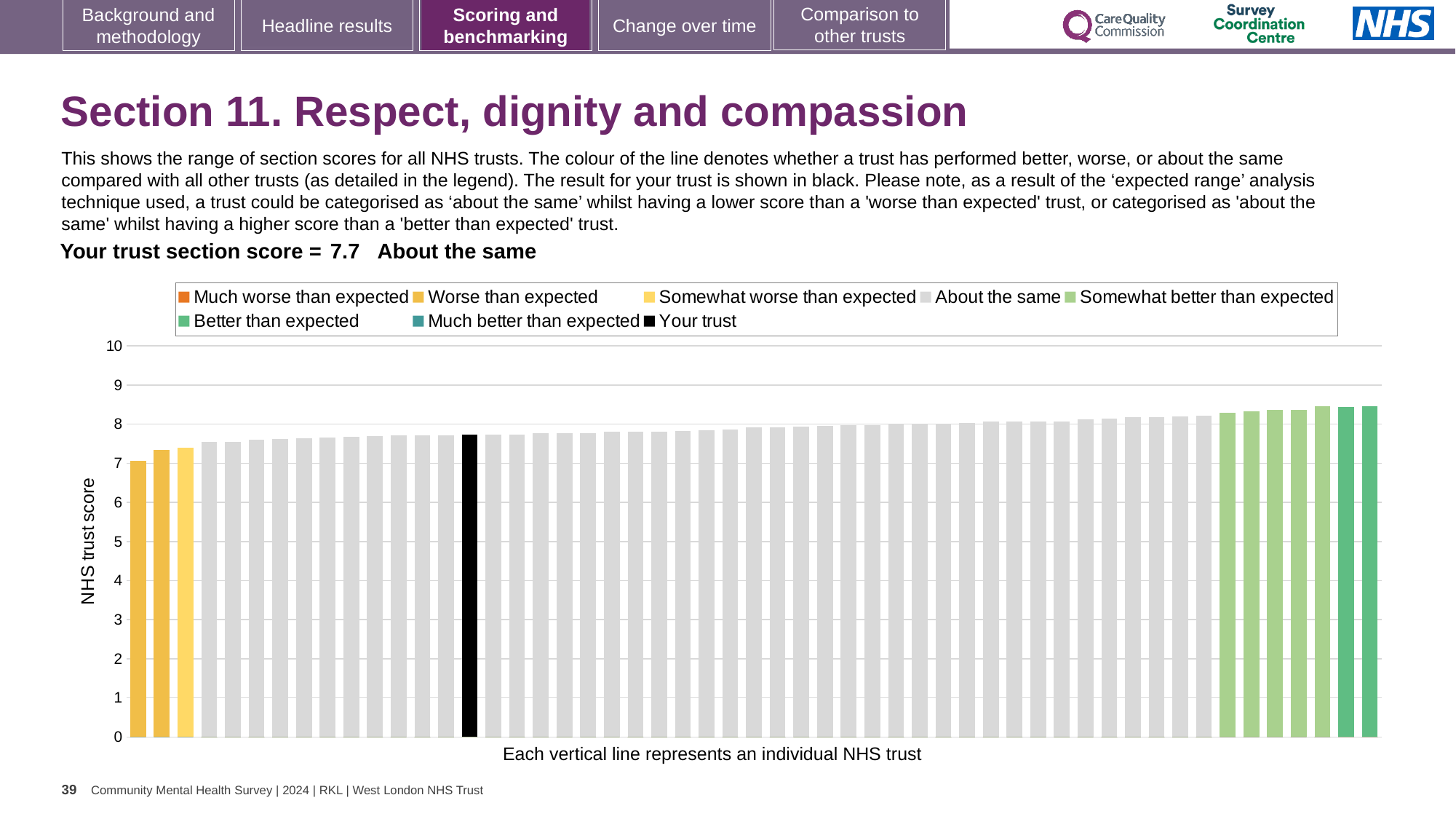
Which bar has the highest score, the leftmost or the rightmost? rightmost Which bar has the lowest score, the leftmost or the rightmost? leftmost How is your trust's section score categorised compared with other trusts? About the same What is the label on the vertical axis? NHS trust score What is the section score for your trust? 7.7 How many entries does the legend list? 8 Do the bar values rise or fall from left to right along the x axis? rise What kind of chart is shown on the slide? bar chart Is the value for the rightmost bar greater or less than 8? greater Is the value for your trust (the black bar) greater or less than 7? greater What colour is the bar representing your trust? black Is the value for the leftmost bar greater or less than 8? less